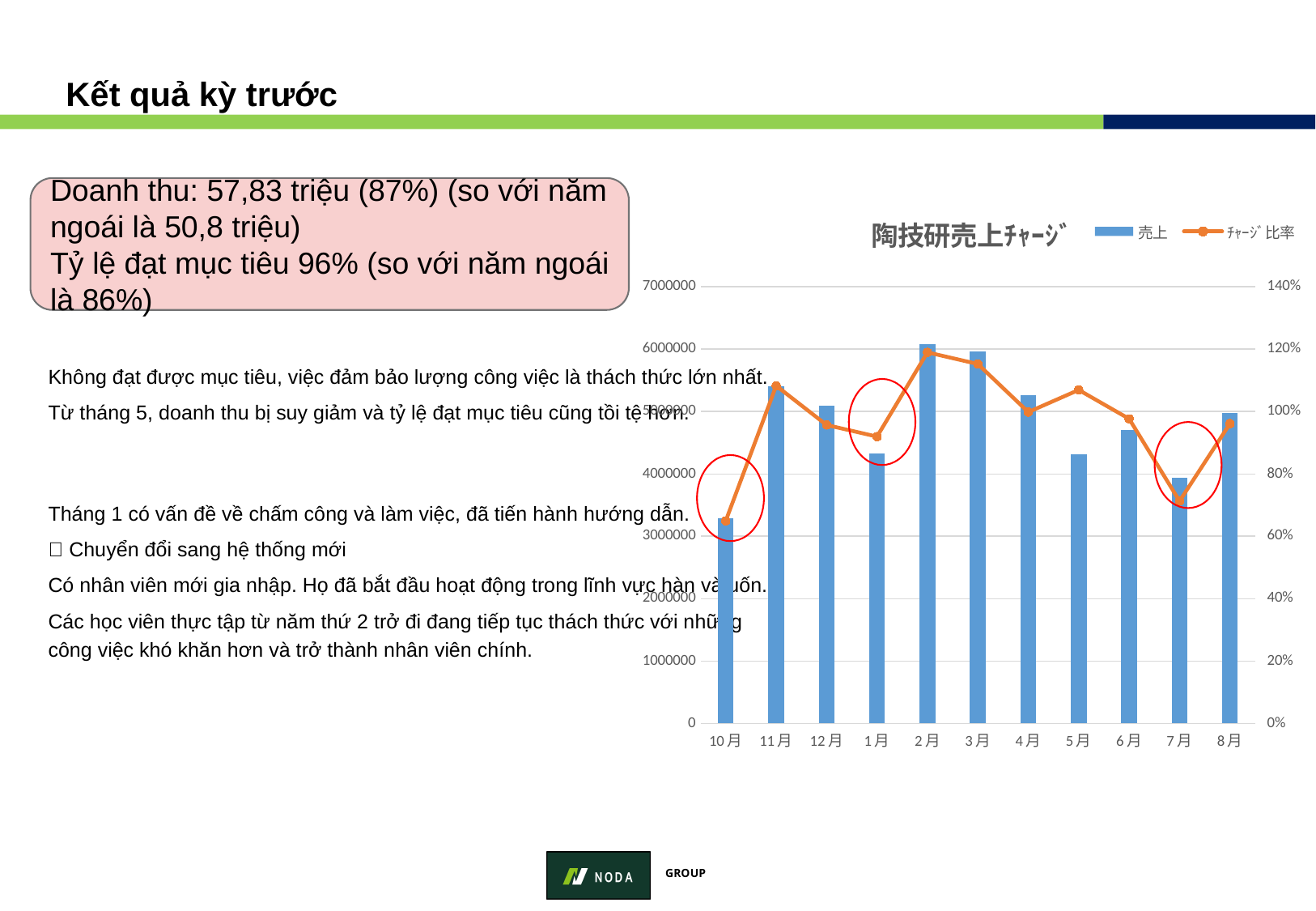
What kind of chart is shown on the slide? A combined bar and line chart Which month has the lowest ﾁｬｰｼﾞ比率 value on the line? 10月 Do the 売上 bars rise or fall from 2月 to 5月? fall Which month has the shortest 売上 bar? 10月 Is the ﾁｬｰｼﾞ比率 value for 7月 greater or less than 80%? less Is the ﾁｬｰｼﾞ比率 value for 2月 greater or less than 100%? greater Which month has the tallest 売上 bar? 2月 Is the 売上 bar for 10月 greater or less than 4000000? less How many series does the chart legend list? 2 How many months are shown on the x axis of the chart? 11 Which month has the taller 売上 bar, 11月 or 12月? 11月